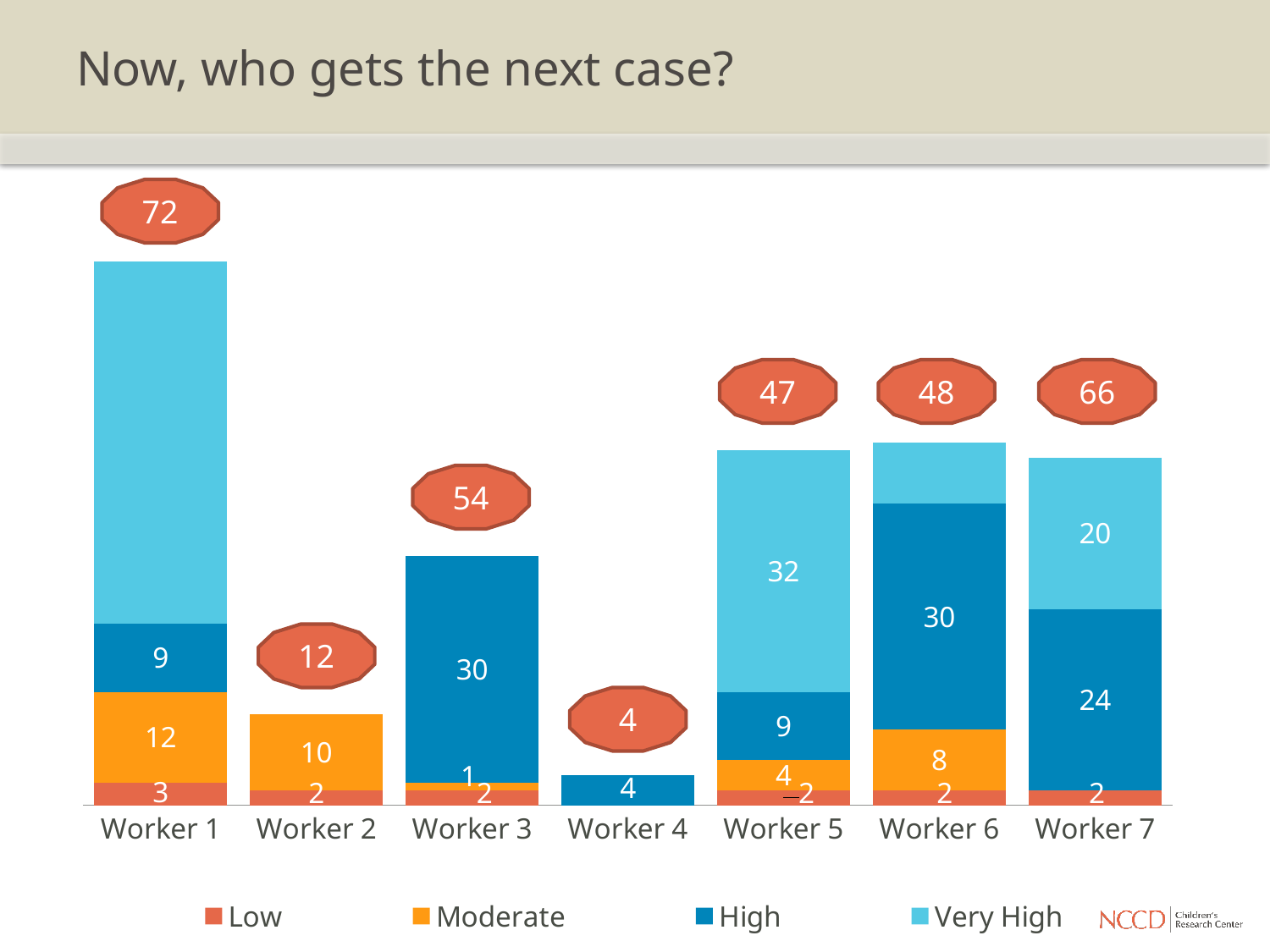
What is the Very High value for Worker 5? 32 What number is shown in the badge above the bar for Worker 3? 54 How many series does the legend list? 4 What kind of chart is shown on the slide? Stacked bar chart Which is larger, the Moderate value for Worker 1 or the Moderate value for Worker 2? Worker 1 What is the High value for Worker 4? 4 Which worker has the tallest stacked bar? Worker 1 What is the difference between the High value for Worker 6 and the High value for Worker 7? 6 Which worker has the shortest stacked bar? Worker 4 How many workers are shown on the x axis? 7 What is the High value for Worker 6? 30 What is the Moderate value for Worker 2? 10